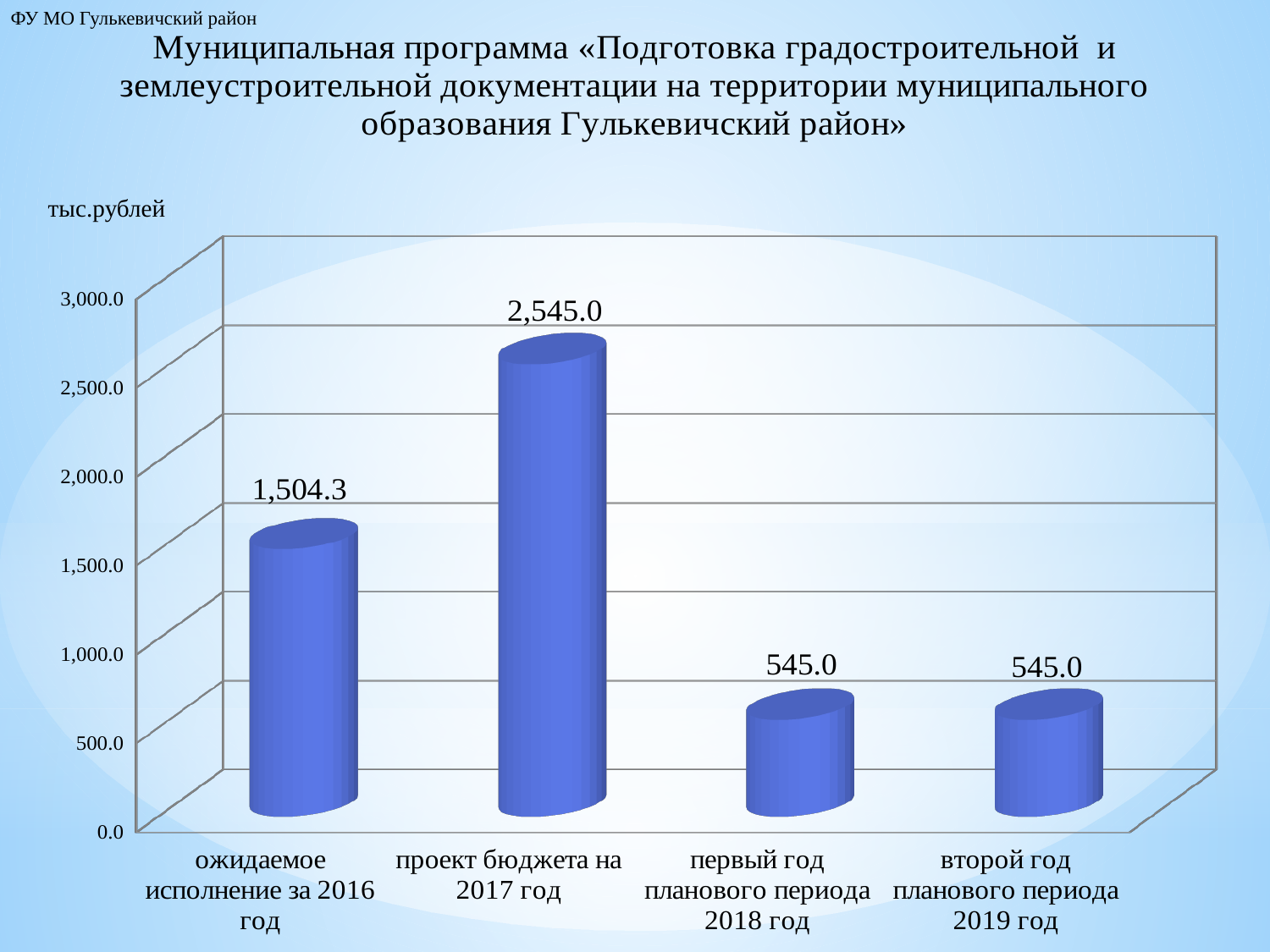
Is the value for «ожидаемое исполнение за 2016 год» greater or less than 2,000.0? less How many categories are shown on the chart? 4 Which category has the highest value? проект бюджета на 2017 год Which is larger: the value for «ожидаемое исполнение за 2016 год» or the value for «второй год планового периода 2019 год»? ожидаемое исполнение за 2016 год What is the value for «второй год планового периода 2019 год»? 545.0 What is the difference between the value for «ожидаемое исполнение за 2016 год» and the value for «первый год планового периода 2018 год»? 959.3 What is the value for «ожидаемое исполнение за 2016 год»? 1,504.3 What is the value for «первый год планового периода 2018 год»? 545.0 What is the value for «проект бюджета на 2017 год»? 2,545.0 In what units are the values on the chart expressed? тыс.рублей What is the difference between the value for «проект бюджета на 2017 год» and the value for «ожидаемое исполнение за 2016 год»? 1,040.7 What kind of chart is shown on the slide? bar chart